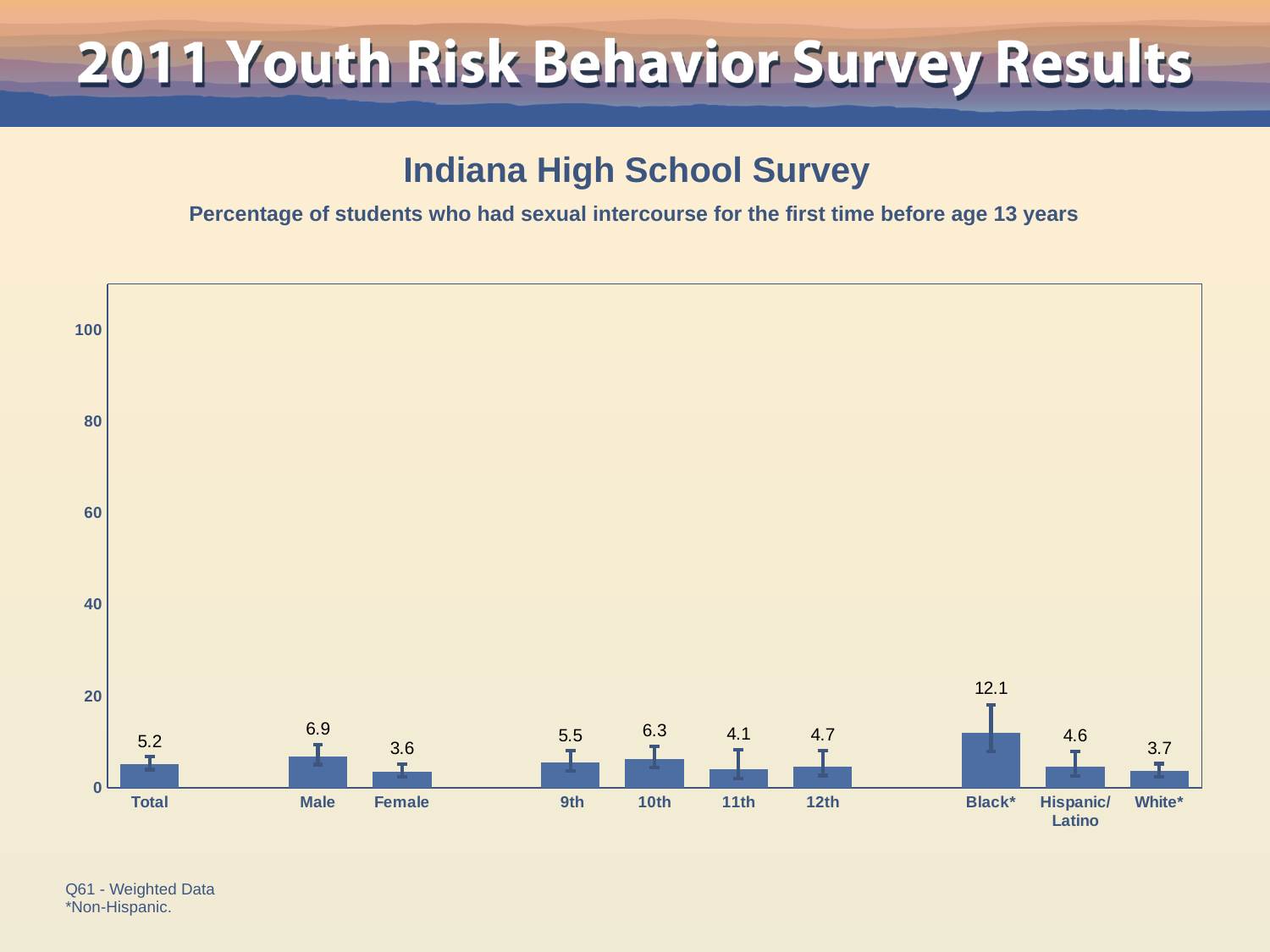
Is the value for Black* greater or less than 20? less Which category has the lowest value? Female What is the value for Hispanic/Latino? 4.6 What is the value for Total? 5.2 What is the difference between the values for Male and Female? 3.3 What is the value for Black*? 12.1 What is the subtitle describing what the chart measures? Percentage of students who had sexual intercourse for the first time before age 13 years Do the values rise or fall from 10th to 11th grade? fall How many categories are shown on the x axis? 10 Which is larger, the value for 9th or the value for 11th? 9th Which category has the highest value? Black* What kind of chart is this? bar chart